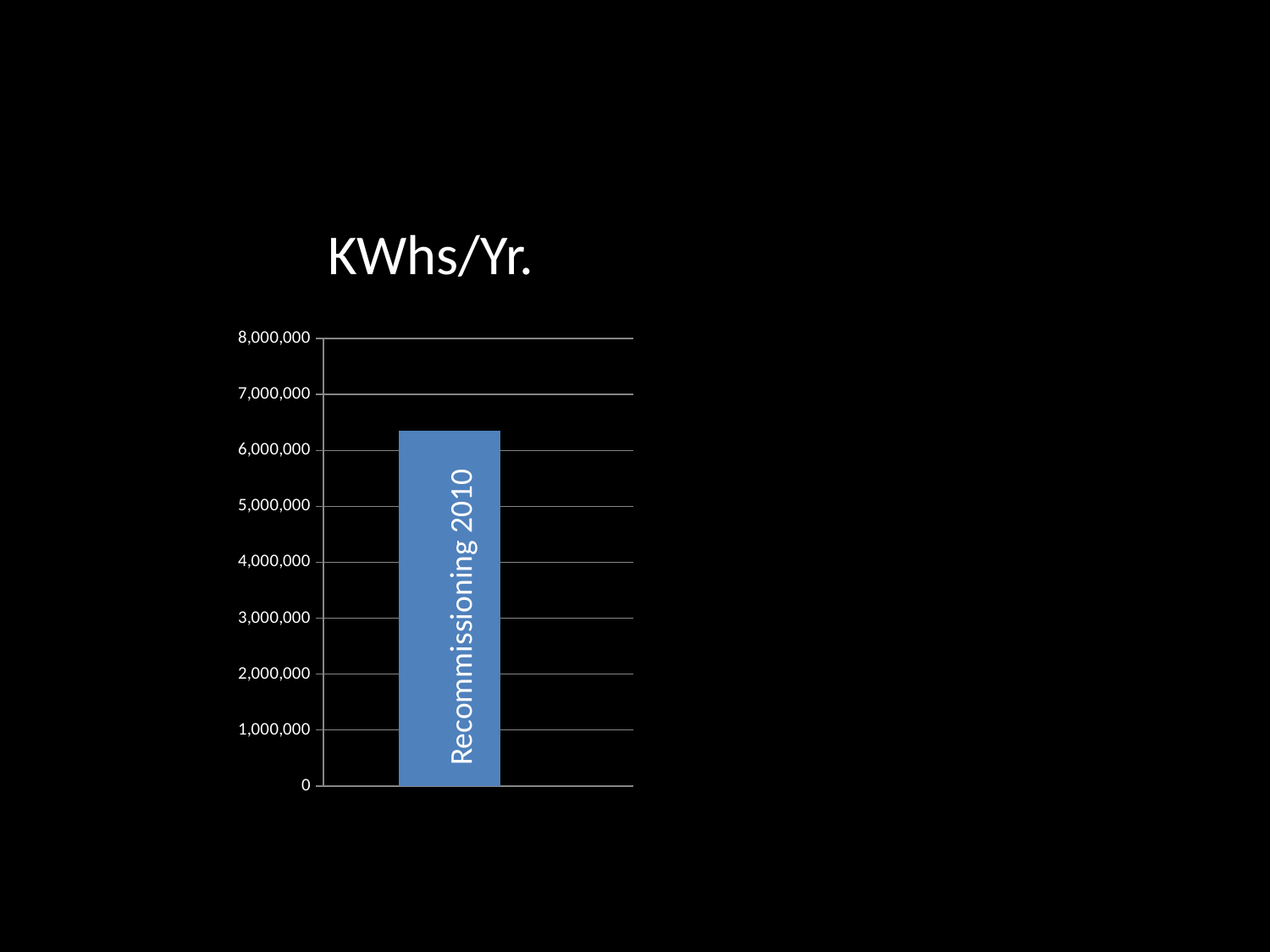
What is the title of the chart? KWhs/Yr. How many bars does the chart show? 1 Is the value for Recommissioning 2010 greater or less than 7,000,000? less Is the value for Recommissioning 2010 greater or less than 6,000,000? greater What kind of chart is shown on the slide? bar chart Is the value for Recommissioning 2010 greater or less than 5,000,000? greater What is the label of the bar in the chart? Recommissioning 2010 What is the highest value shown on the vertical axis? 8,000,000